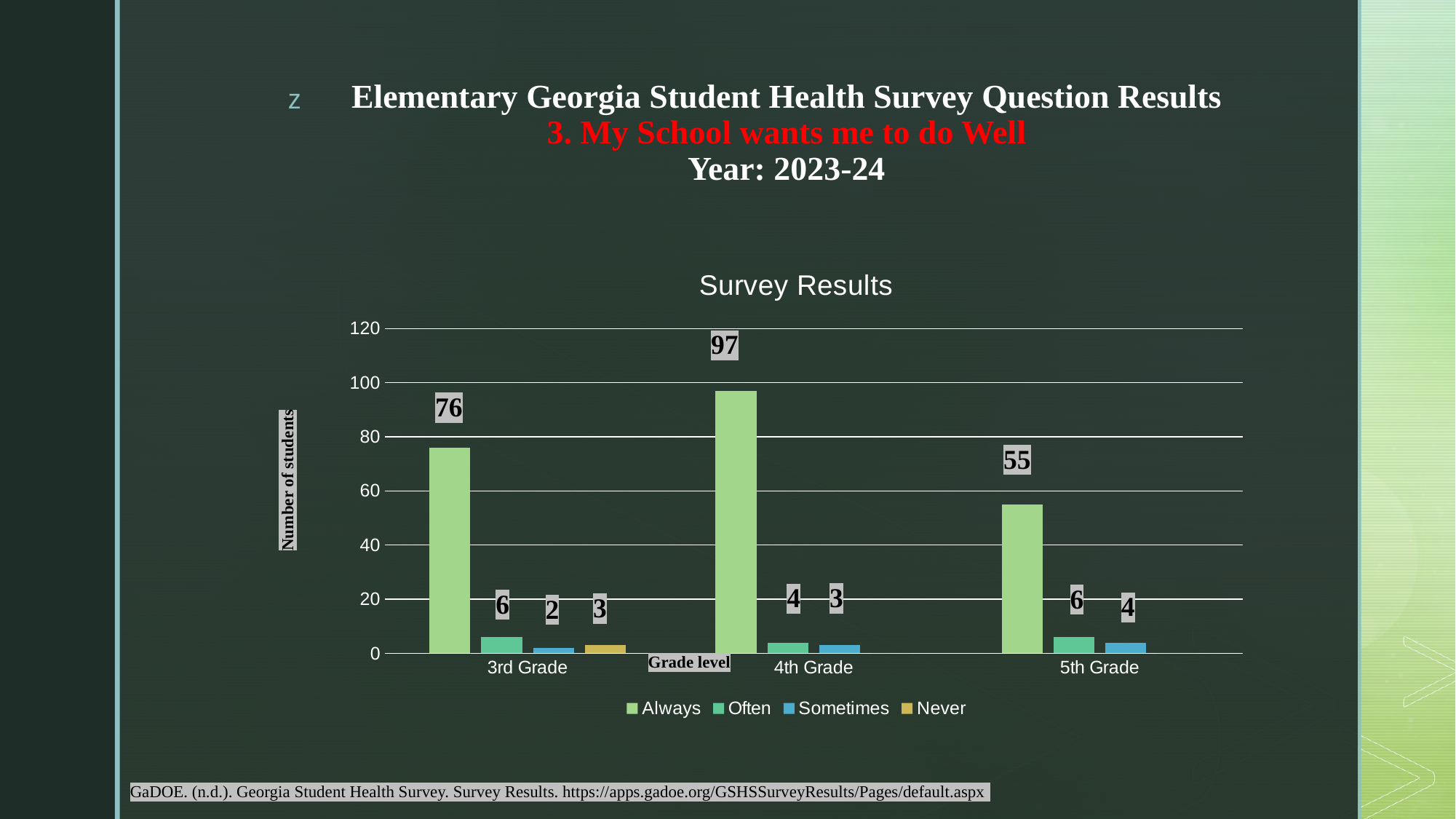
Which is larger, the Always value for 3rd Grade or for 5th Grade? 3rd Grade Which grade level has the highest value for Always? 4th Grade What is the value for Sometimes in 5th Grade? 4 What is the value for Often in 3rd Grade? 6 How many grade levels are shown on the x axis? 3 Which grade level has the lowest value for Always? 5th Grade What kind of chart is shown on the slide? Bar chart What is the title of the chart? Survey Results How many series does the legend list? 4 What is the value for Always in 4th Grade? 97 What is the value for Never in 3rd Grade? 3 What is the difference between the Always values for 4th Grade and 3rd Grade? 21